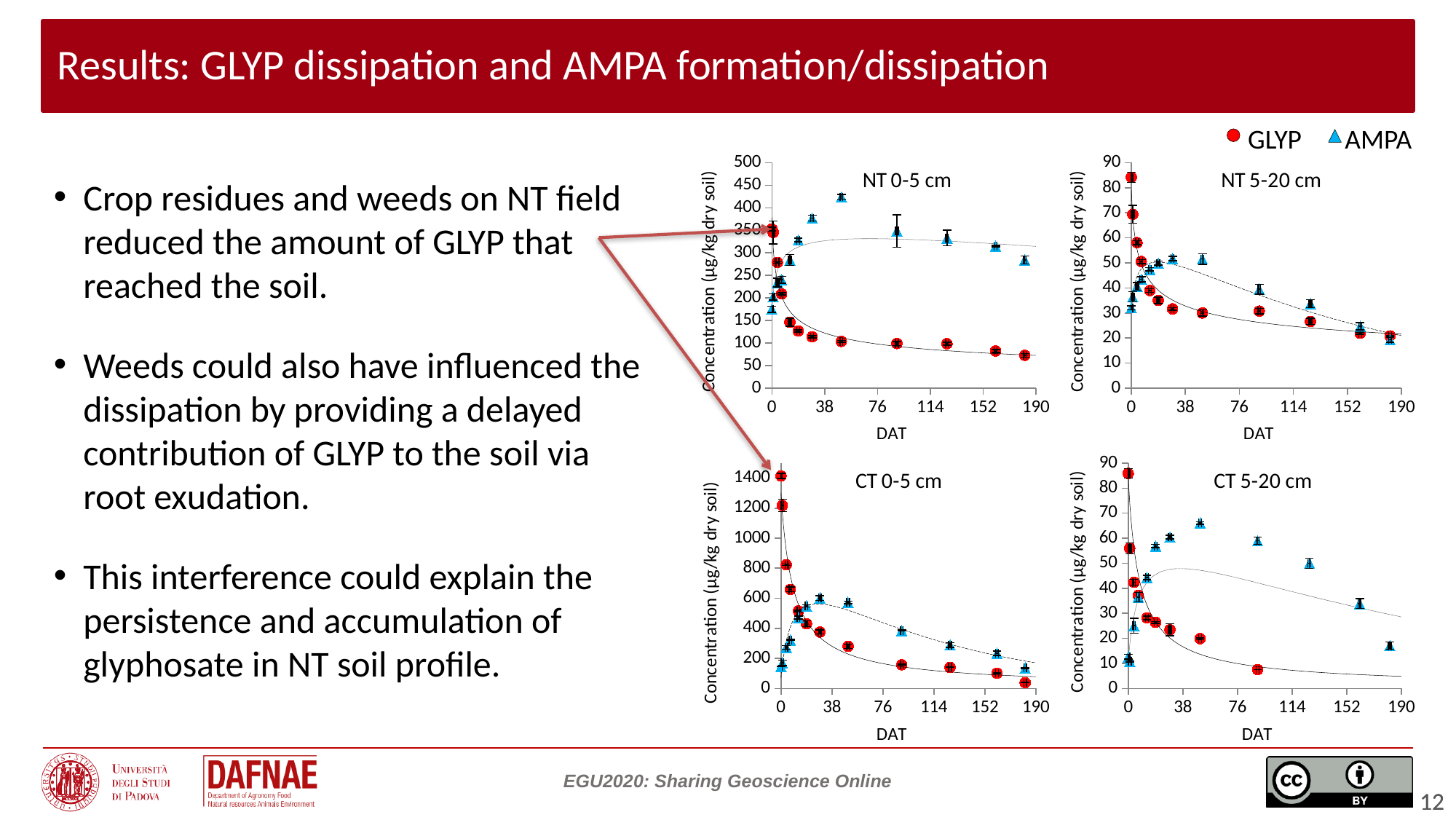
In the NT 0-5 cm chart, is the GLYP value at DAT 0 greater or less than 300? greater How many series does the legend list for the charts? 2 In the NT 5-20 cm chart, is the GLYP value at DAT 0 greater or less than 70? greater In the CT 0-5 cm chart, at DAT 0, which series has the larger value, GLYP or AMPA? GLYP How many charts are shown on the slide? 4 In the NT 0-5 cm chart, at the last sampling point near DAT 190, which series has the larger value, GLYP or AMPA? AMPA In the CT 0-5 cm chart, do the GLYP values rise or fall along the x axis? fall What is the label on the x axis of the charts? DAT In the NT 0-5 cm chart, do the GLYP values rise or fall along the x axis? fall What kind of chart is the NT 0-5 cm chart? scatter chart What are the two series named in the legend? GLYP and AMPA In the CT 0-5 cm chart, is the GLYP value at DAT 0 greater or less than 1200? greater